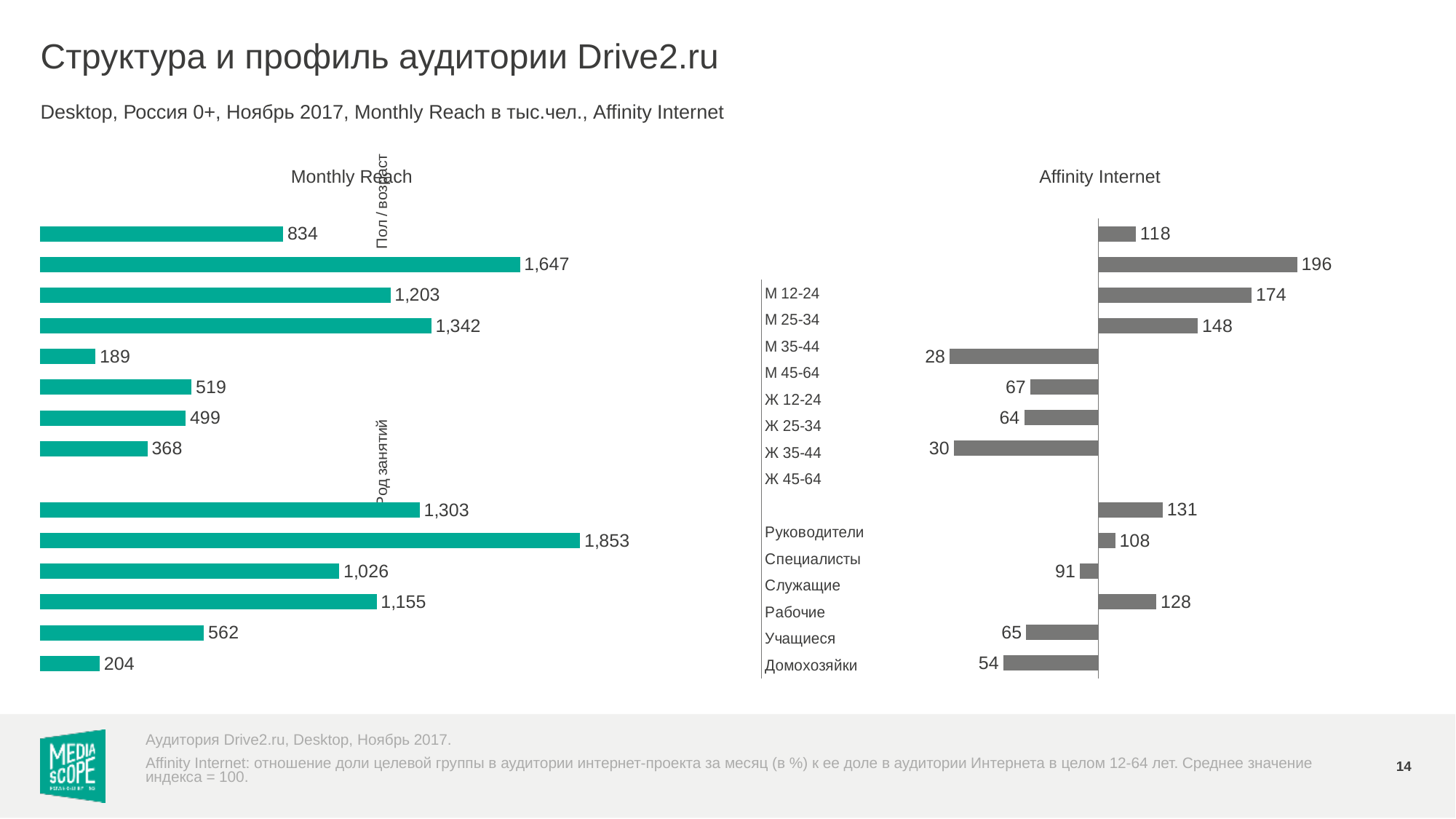
How many bars are plotted in the Monthly Reach chart? 14 In the Affinity Internet chart, which is larger: the value of the second bar from the top or the value of the third bar from the top? the second bar from the top (196) In the Affinity Internet chart, what is the value of the bottommost bar? 54 What colour are the bars in the Affinity Internet chart? grey In the Monthly Reach chart, what is the difference between the two largest values, 1,853 and 1,647? 206 In the Affinity Internet chart, what is the highest value shown? 196 In the Monthly Reach chart, what is the value of the topmost bar? 834 In the Monthly Reach chart, what is the highest value shown? 1,853 How many bars are plotted in the Affinity Internet chart? 14 What kind of chart is the Monthly Reach chart on the left? bar chart In the Monthly Reach chart, what is the lowest value shown? 189 In the Affinity Internet chart, what is the lowest value shown? 28